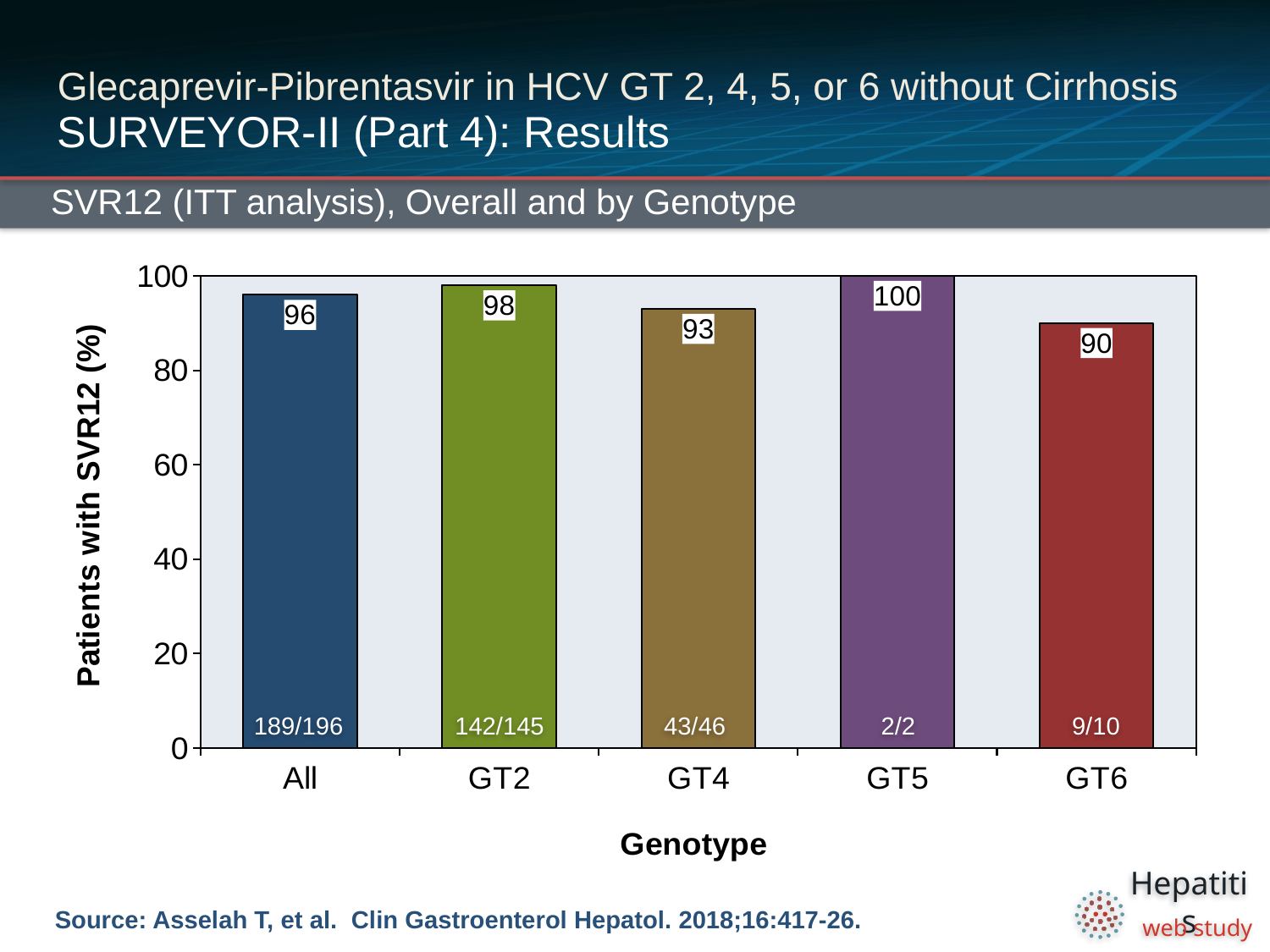
Which genotype group has the highest SVR12 rate? GT5 What is the SVR12 rate for the GT2 group? 98 Which genotype group has the lowest SVR12 rate? GT6 What is the SVR12 rate for GT6? 90 What type of chart is shown on the slide? Bar chart What is the label of the y-axis? Patients with SVR12 (%) What is the title of the chart? SVR12 (ITT analysis), Overall and by Genotype How many bars are shown in the chart? 5 Which has a higher SVR12 rate, GT2 or GT4? GT2 What is the SVR12 rate for the All group? 96 What fraction of patients is shown inside the GT4 bar? 43/46 What is the difference in SVR12 rate between GT5 and GT6? 10